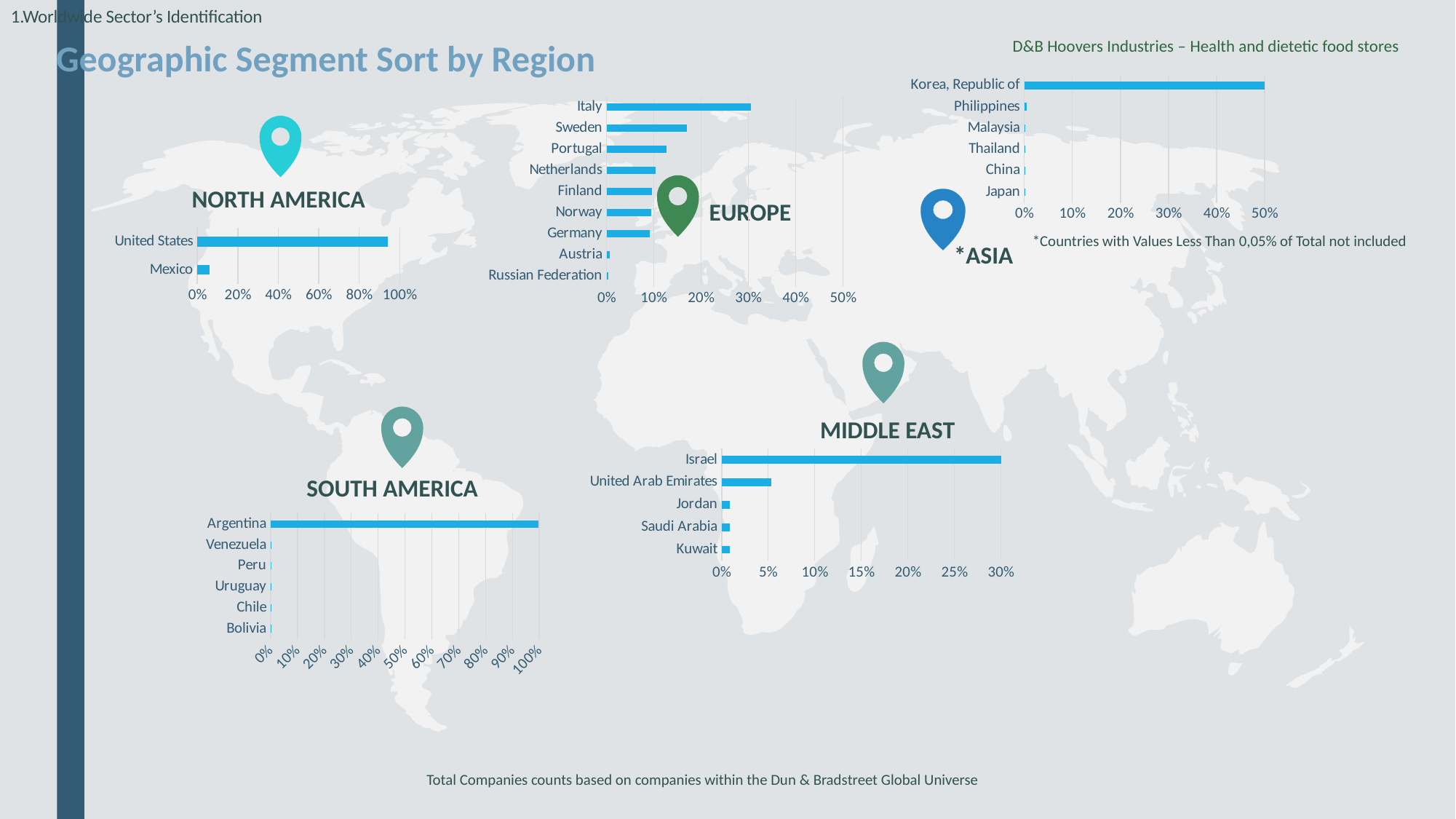
In the NORTH AMERICA chart, is the value for United States greater or less than 80%? greater In the NORTH AMERICA chart, which country has the highest value? United States What kind of chart is the MIDDLE EAST chart? bar chart How many countries are shown in the EUROPE chart? 9 In the EUROPE chart, is the value for Italy greater or less than 20%? greater In the SOUTH AMERICA chart, which country has the highest value? Argentina How many countries are shown in the ASIA chart? 6 In the NORTH AMERICA chart, is the value for Mexico greater or less than 20%? less In the EUROPE chart, which is larger, the value for Sweden or the value for Portugal? Sweden In the EUROPE chart, which country has the highest value? Italy